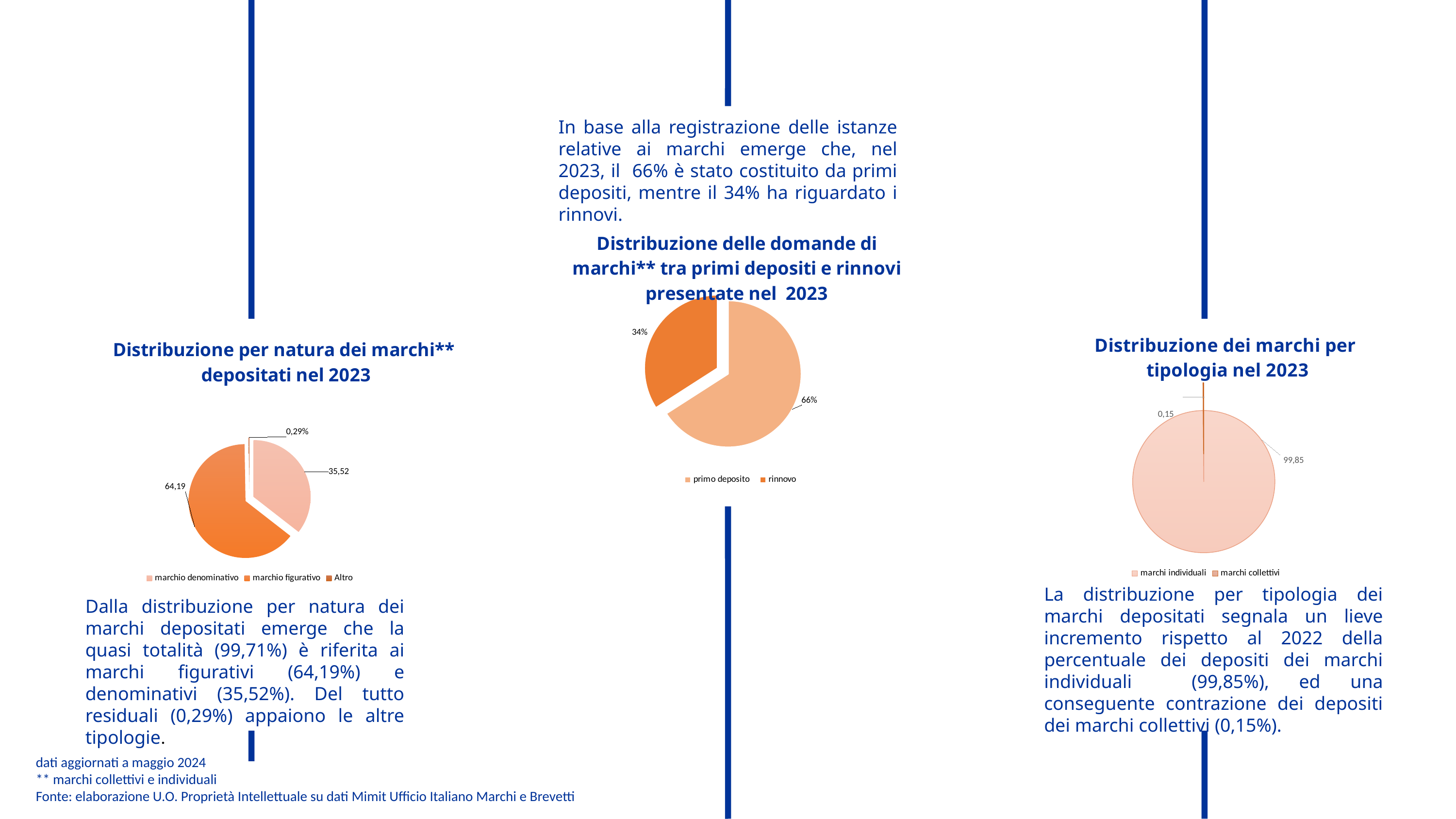
In the chart 'Distribuzione delle domande di marchi** tra primi depositi e rinnovi presentate nel 2023', which is larger, primo deposito or rinnovo? primo deposito In the chart 'Distribuzione dei marchi per tipologia nel 2023', what is the value for marchi collettivi? 0,15 How many pie charts are shown on the slide? 3 In the chart 'Distribuzione per natura dei marchi** depositati nel 2023', what is the value for marchio denominativo? 35,52 In the chart 'Distribuzione dei marchi per tipologia nel 2023', what is the value for marchi individuali? 99,85 In the chart 'Distribuzione delle domande di marchi** tra primi depositi e rinnovi presentate nel 2023', what share is primo deposito? 66% In the chart 'Distribuzione per natura dei marchi** depositati nel 2023', what is the value for marchio figurativo? 64,19 In the chart 'Distribuzione per natura dei marchi** depositati nel 2023', which category has the smallest slice? Altro In the chart 'Distribuzione per natura dei marchi** depositati nel 2023', how many categories does the legend list? 3 In the chart 'Distribuzione delle domande di marchi** tra primi depositi e rinnovi presentate nel 2023', what share is rinnovo? 34% In the chart 'Distribuzione per natura dei marchi** depositati nel 2023', what is the difference between marchio figurativo and marchio denominativo? 28,67 What kind of chart is 'Distribuzione delle domande di marchi** tra primi depositi e rinnovi presentate nel 2023'? pie chart